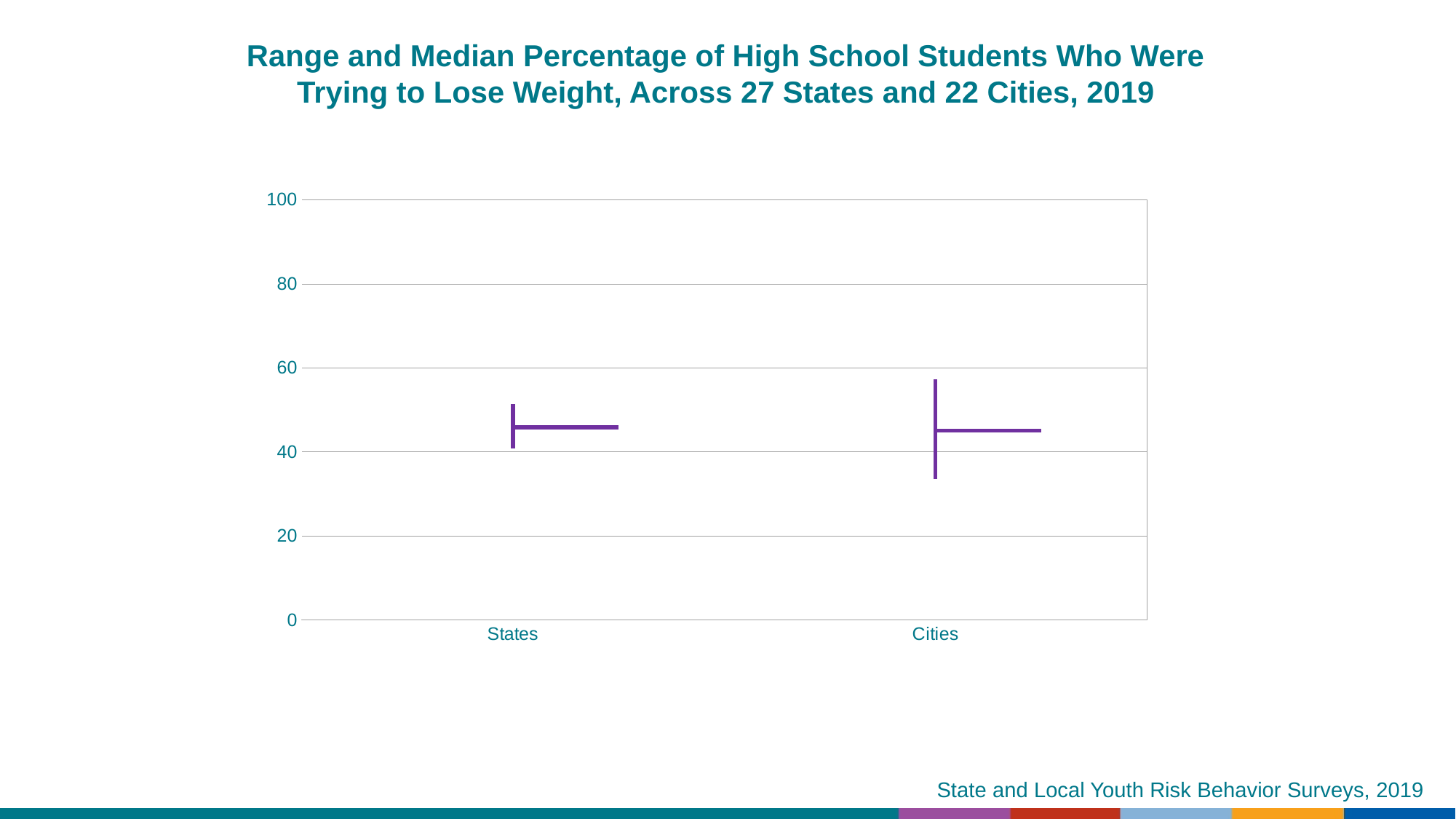
Which category has the lower bottom of its range, States or Cities? Cities What is the highest value shown on the y axis? 100 How many categories are shown on the x axis of the chart? 2 Which category has the wider range, States or Cities? Cities What are the two categories shown on the x axis? States and Cities Is the bottom of the range for Cities greater or less than 40? less Is the median value for States greater or less than 60? less Is the median value for Cities greater or less than 40? greater What year does the chart title say the data are from? 2019